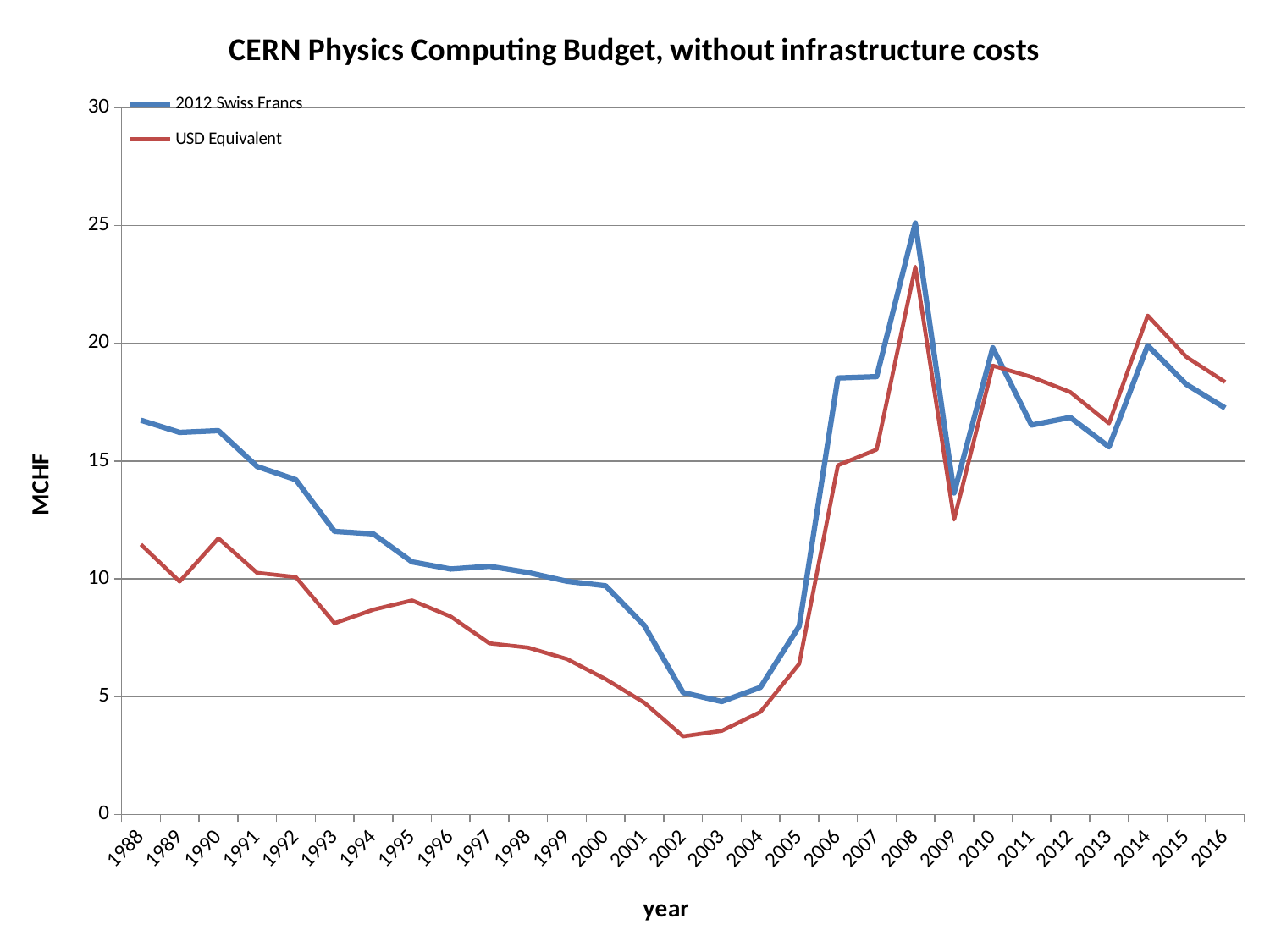
What kind of chart is shown on the slide? line chart In 2014, which series has the larger value, 2012 Swiss Francs or USD Equivalent? USD Equivalent In which year does the 2012 Swiss Francs series reach its highest value? 2008 How many years are plotted along the x axis? 29 How many series does the legend list? 2 In 1988, which series has the larger value, 2012 Swiss Francs or USD Equivalent? 2012 Swiss Francs Does the 2012 Swiss Francs series generally rise or fall from 1988 to 2003? fall Is the value for 2012 Swiss Francs in 2008 greater or less than 20? greater In which year does the 2012 Swiss Francs series reach its lowest value? 2003 In which year does the USD Equivalent series reach its lowest value? 2002 Is the value for USD Equivalent in 2002 greater or less than 5? less Is the value for USD Equivalent in 2009 greater or less than 15? less